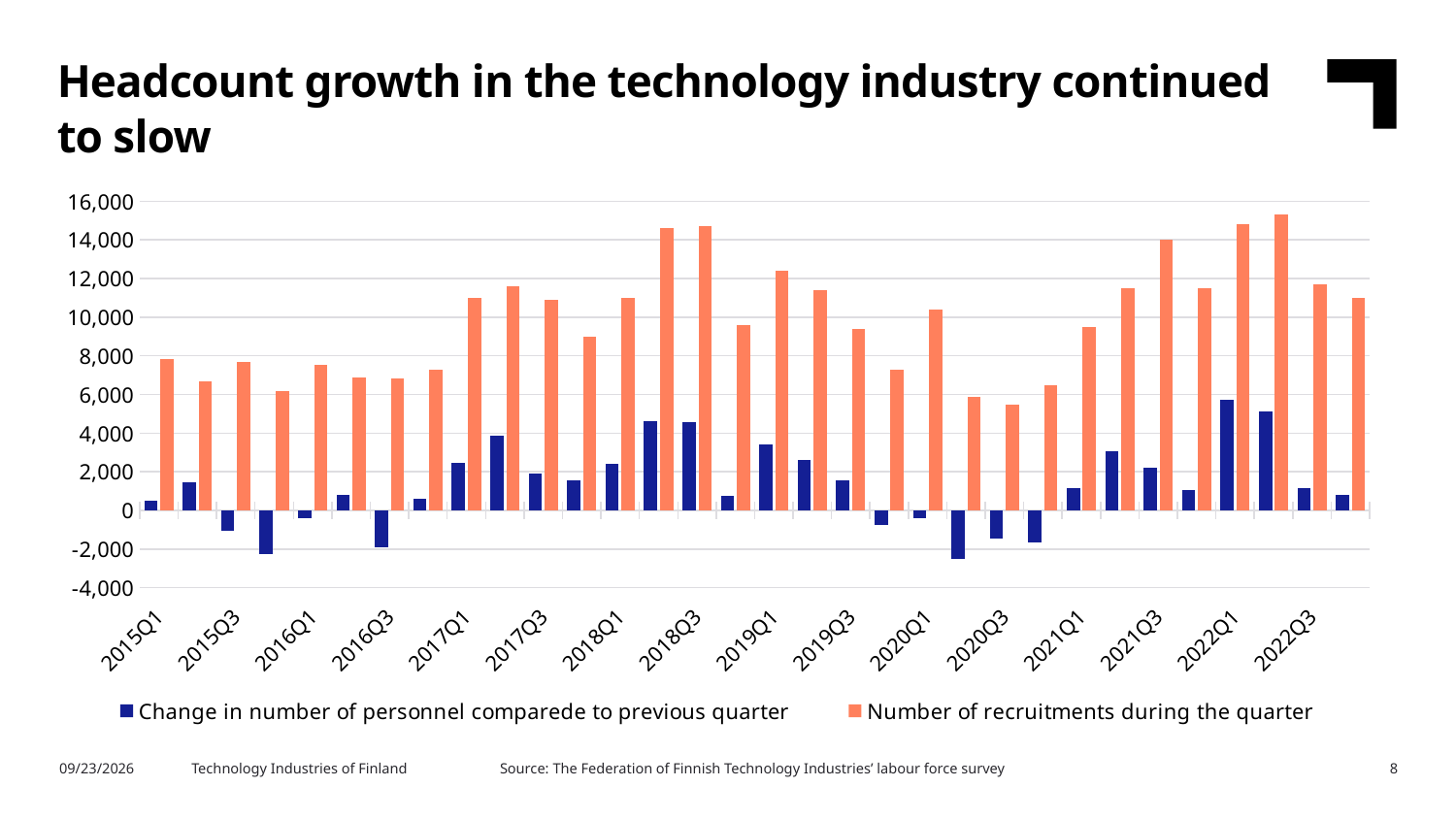
Is the number of recruitments in 2018Q3 greater or less than 14,000? greater Which quarter has the highest change in number of personnel compared to previous quarter? 2022Q1 How many quarters are plotted along the x axis? 32 How many series does the legend list? 2 Is the number of recruitments in 2020Q4 greater or less than 6,000? greater What colour are the bars for the number of recruitments during the quarter? Orange Which quarter has the highest number of recruitments during the quarter? 2022Q2 Is the number of recruitments in 2015Q1 greater or less than 6,000? greater Does the number of recruitments rise or fall from 2020Q4 to 2022Q2? Rise Which quarter had more recruitments, 2016Q4 or 2017Q1? 2017Q1 What kind of chart is shown on the slide? Bar chart